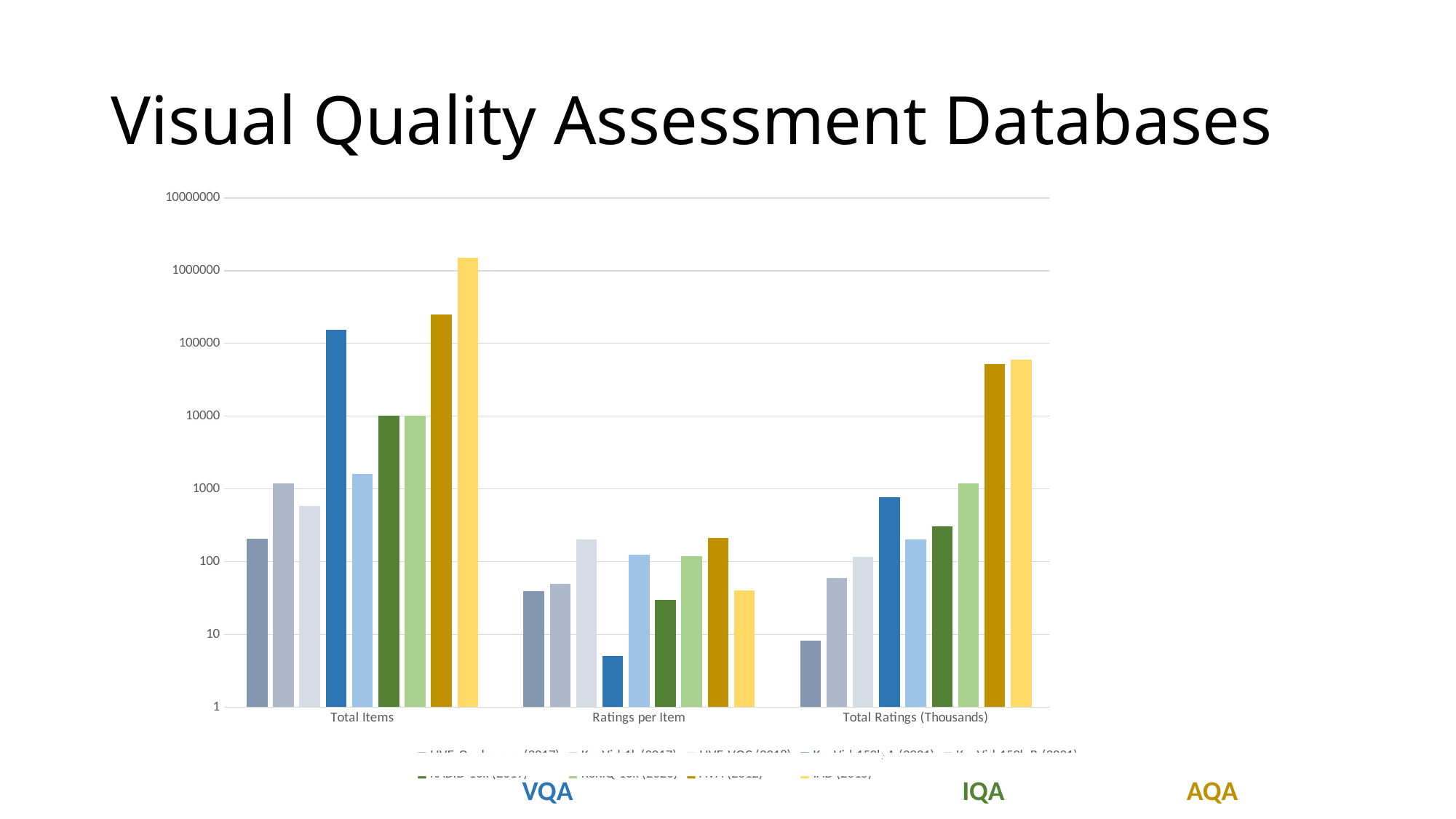
Is the value of the dark gold bar in the Total Items category greater or less than 100000? greater What kind of chart is shown on the slide? bar chart Is the value of the dark blue bar in the Total Items category greater or less than 100000? greater Which category contains the tallest bar in the chart? Total Items Is the value of the tallest bar in the Total Items category greater or less than 1000000? greater What is the highest tick value shown on the y axis of the chart? 10000000 How many bars are plotted in each category of the chart? 9 How many categories are shown on the x axis of the chart? 3 What are the three category labels on the x axis of the chart? Total Items, Ratings per Item, Total Ratings (Thousands)